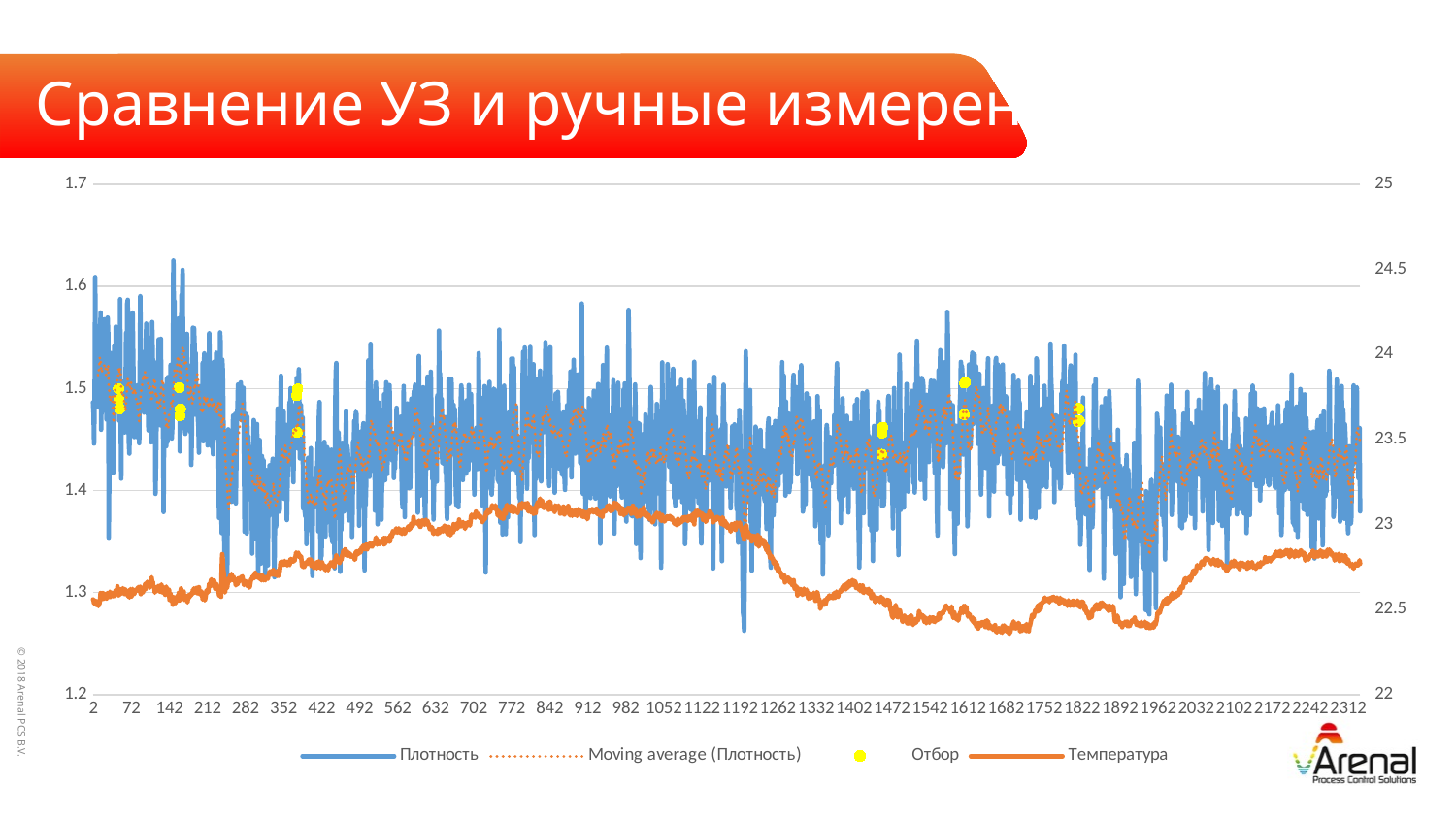
Which series is plotted as yellow dots? Отбор How many series does the legend list? 4 Is the Температура value around x = 842 greater or less than 22.5? greater Which series is drawn as a dotted line? Moving average (Плотность) Is the Moving average (Плотность) line around x = 1052 greater or less than 1.4? greater What kind of chart is shown on the slide? line chart What is the lowest value shown on the right vertical axis? 22 What is the highest value shown on the left vertical axis? 1.7 Is the Moving average (Плотность) line around x = 2312 greater or less than 1.5? less Does the Moving average (Плотность) line overall rise or fall from the left end to the right end of the x axis? fall